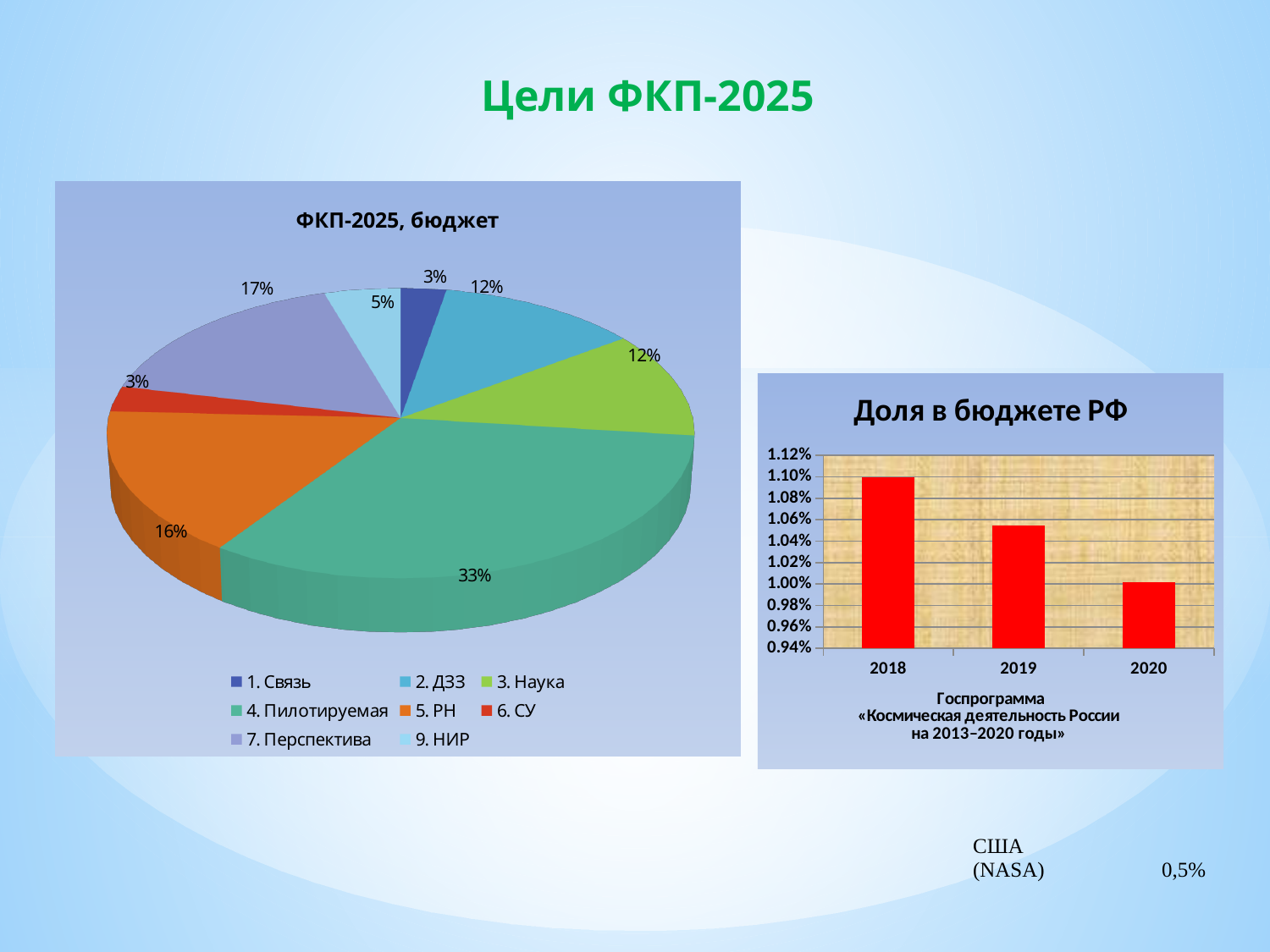
In the pie chart "ФКП-2025, бюджет", how many percentage points larger is "4. Пилотируемая" than "7. Перспектива"? 16 percentage points In the chart "Доля в бюджете РФ", is the value for 2020 greater or less than 1.04%? less In the pie chart "ФКП-2025, бюджет", what share does "5. РН" have? 16% In the chart "Доля в бюджете РФ", how many years are shown on the x axis? 3 What kind of chart is the chart titled "Доля в бюджете РФ"? Bar chart In the pie chart "ФКП-2025, бюджет", which is larger: "2. ДЗЗ" or "9. НИР"? 2. ДЗЗ In the pie chart "ФКП-2025, бюджет", which category has the largest slice? 4. Пилотируемая In the chart "Доля в бюджете РФ", do the values rise or fall from 2018 to 2020? Fall What kind of chart is the chart titled "ФКП-2025, бюджет"? Pie chart In the pie chart "ФКП-2025, бюджет", what share does "7. Перспектива" have? 17% In the pie chart "ФКП-2025, бюджет", how many entries does the legend list? 8 In the pie chart "ФКП-2025, бюджет", what share does "4. Пилотируемая" have? 33%